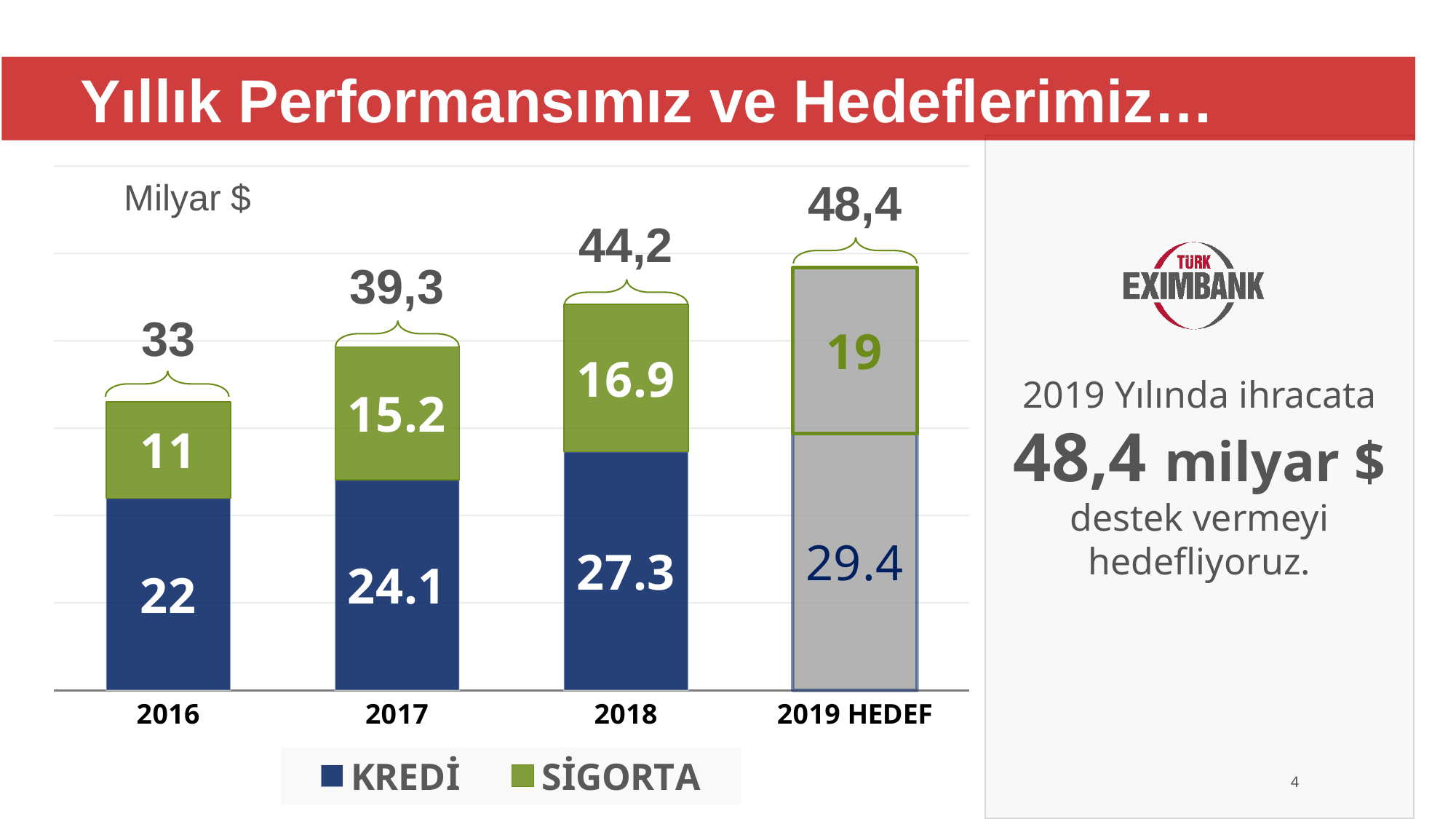
What is the total shown above the 2019 HEDEF bar? 48,4 How many categories are shown on the x axis? 4 What is the difference between the KREDİ values for 2018 and 2016? 5.3 What is the KREDİ value for 2017? 24.1 Which is larger, the SİGORTA value for 2017 or the SİGORTA value for 2018? 2018 What is the SİGORTA value for 2018? 16.9 Which category has the highest KREDİ value? 2019 HEDEF How many series does the legend list? 2 Do the bar totals rise or fall from 2016 to 2019 HEDEF? rise What is the SİGORTA value for 2019 HEDEF? 19 What is the total shown above the 2017 bar? 39,3 Which category has the lowest SİGORTA value? 2016